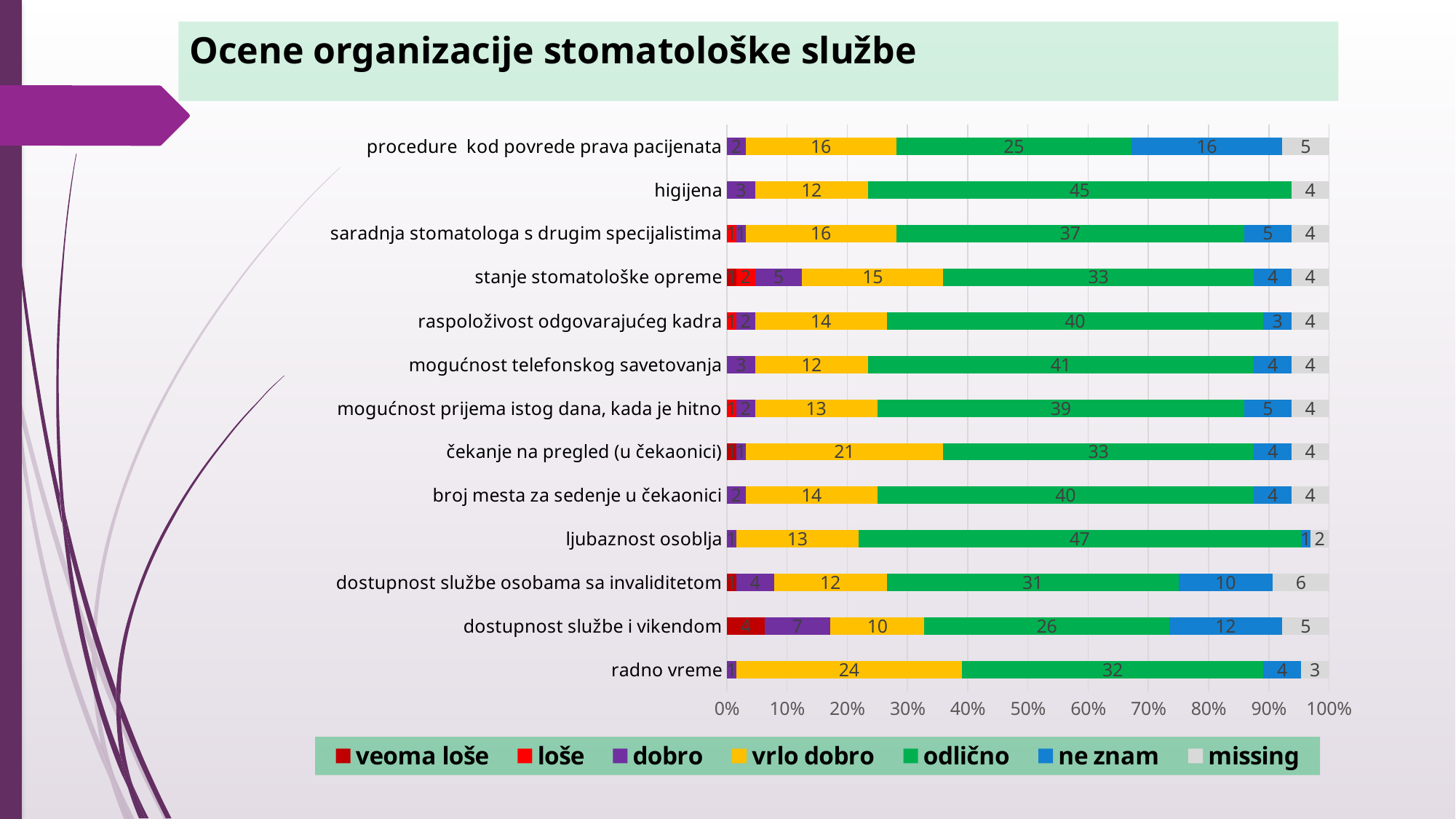
What is the 'ne znam' value for 'procedure kod povrede prava pacijenata'? 16 What is the total of the stacked bar for 'higijena'? 64 How many categories are plotted on the chart? 13 How many series does the legend list? 7 Which category has the highest 'odlično' value? ljubaznost osoblja Which has the larger 'odlično' value, 'higijena' or 'radno vreme'? higijena What is the difference between the 'odlično' values for 'higijena' and 'procedure kod povrede prava pacijenata'? 20 What is the 'dobro' value for 'dostupnost službe i vikendom'? 7 What is the 'odlično' value for 'higijena'? 45 What is the 'vrlo dobro' value for 'radno vreme'? 24 Which category has the lowest 'odlično' value? procedure kod povrede prava pacijenata What kind of chart is shown on the slide? stacked bar chart